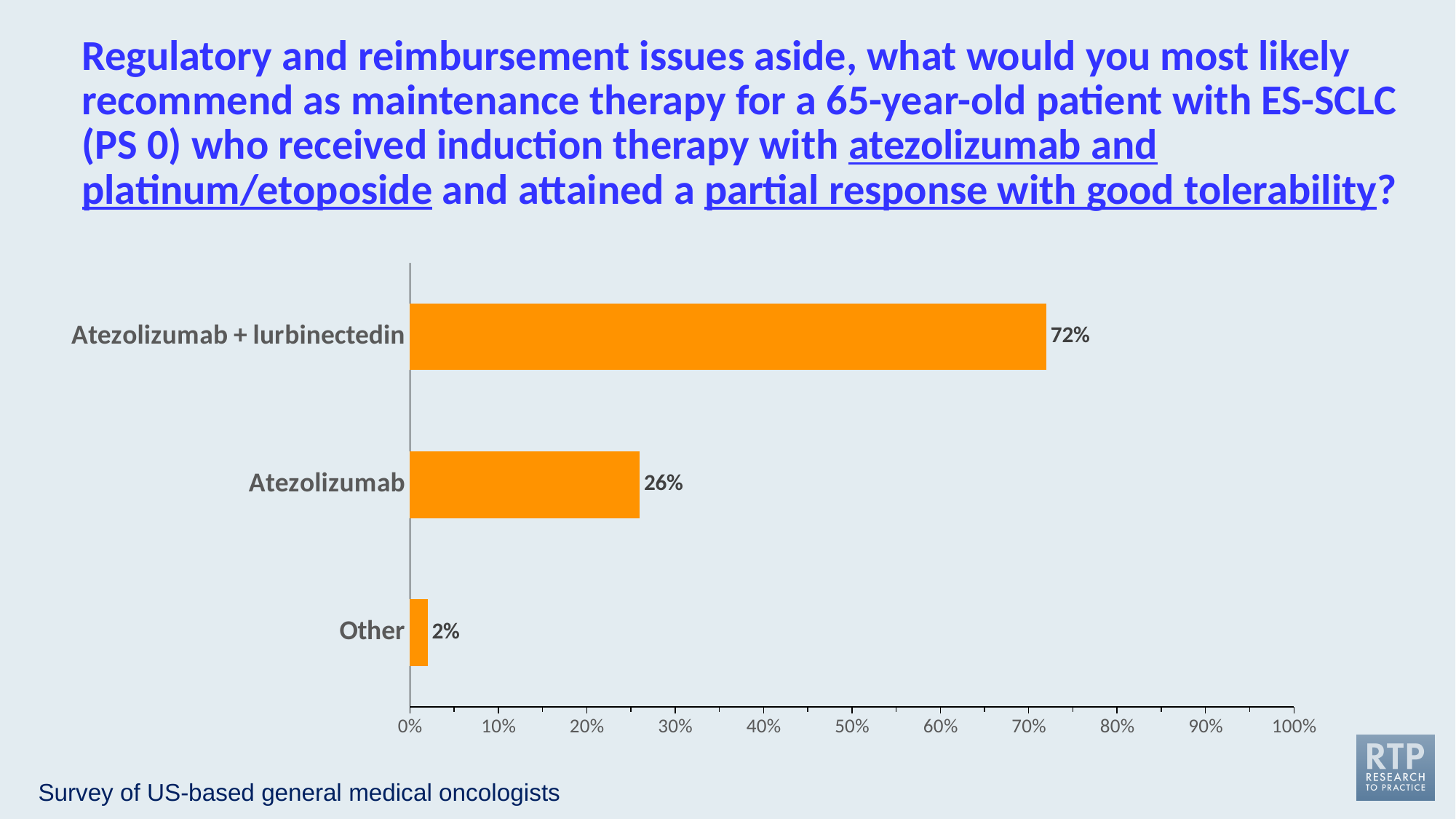
What percentage of respondents chose Atezolizumab alone? 26% What is the maximum value shown on the horizontal axis? 100% What is the difference in percentage points between Atezolizumab + lurbinectedin and Atezolizumab? 46 percentage points Which received a larger share of responses, Atezolizumab or Other? Atezolizumab Which option received the highest percentage of responses? Atezolizumab + lurbinectedin What is the difference in percentage points between Atezolizumab and Other? 24 percentage points How many response options are shown in the chart? 3 What percentage of respondents chose Atezolizumab + lurbinectedin? 72% Which option received the lowest percentage of responses? Other Is the value for Atezolizumab + lurbinectedin greater or less than 50%? greater What type of chart is shown on the slide? Bar chart What percentage of respondents chose Other? 2%